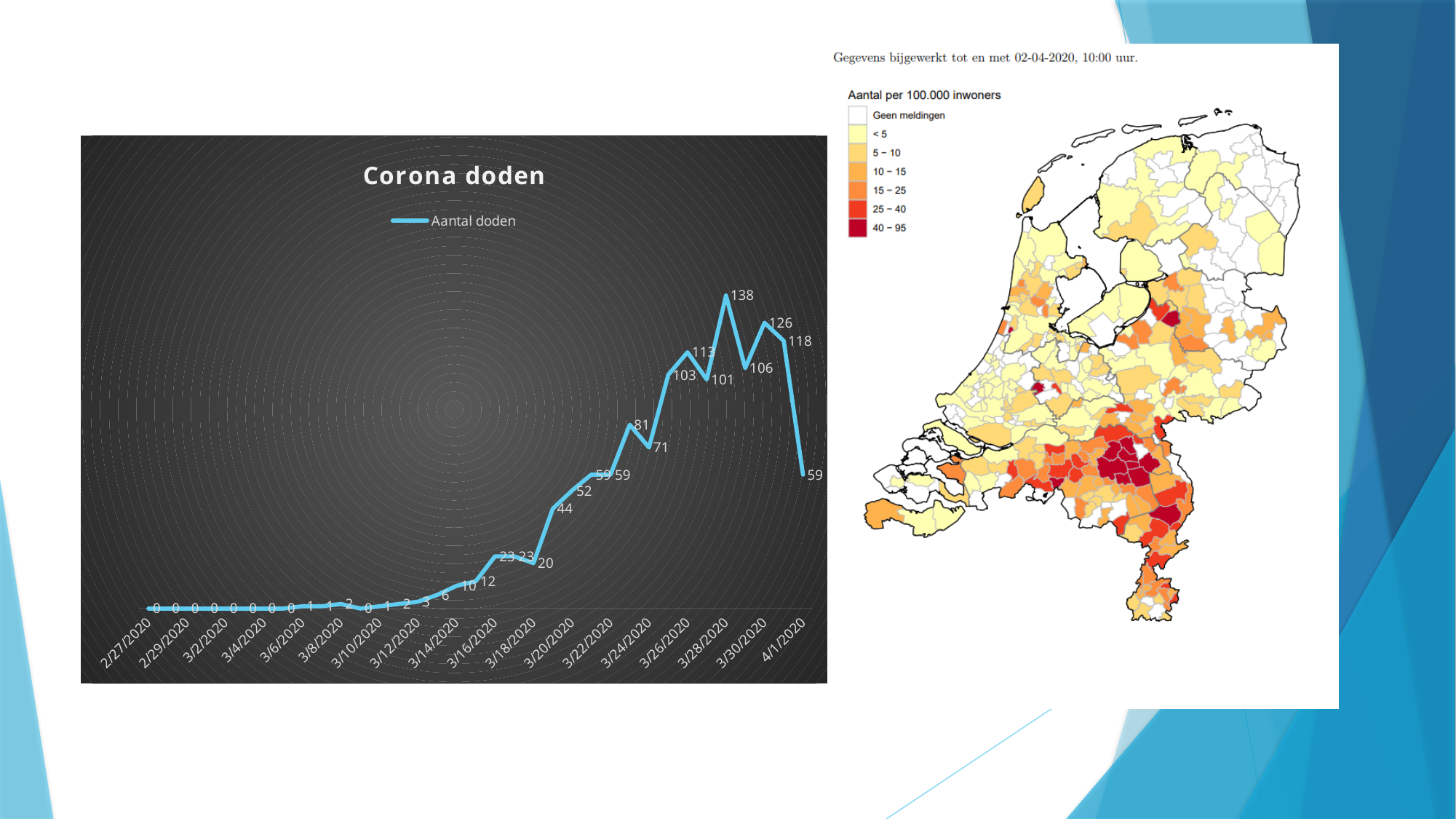
How many series does the legend of the 'Corona doden' chart list? 1 In the 'Corona doden' chart, on which date is the number of deaths highest? 3/28/2020 In the 'Corona doden' chart, what is the value on 3/30/2020? 126 What kind of chart is 'Corona doden'? line chart In the 'Corona doden' chart, what is the value on 3/28/2020? 138 In the 'Corona doden' chart, what is the value on 4/1/2020? 59 In the 'Corona doden' chart, what is the value on 3/26/2020? 113 In the 'Corona doden' chart, which date has the larger value, 3/24/2020 or 3/26/2020? 3/26/2020 What is the name of the series in the 'Corona doden' chart legend? Aantal doden What is the title of the line chart on the left of the slide? Corona doden In the 'Corona doden' chart, do the values generally rise or fall from 2/27/2020 to 3/28/2020? rise In the 'Corona doden' chart, what is the difference between the values on 3/28/2020 and 3/30/2020? 12